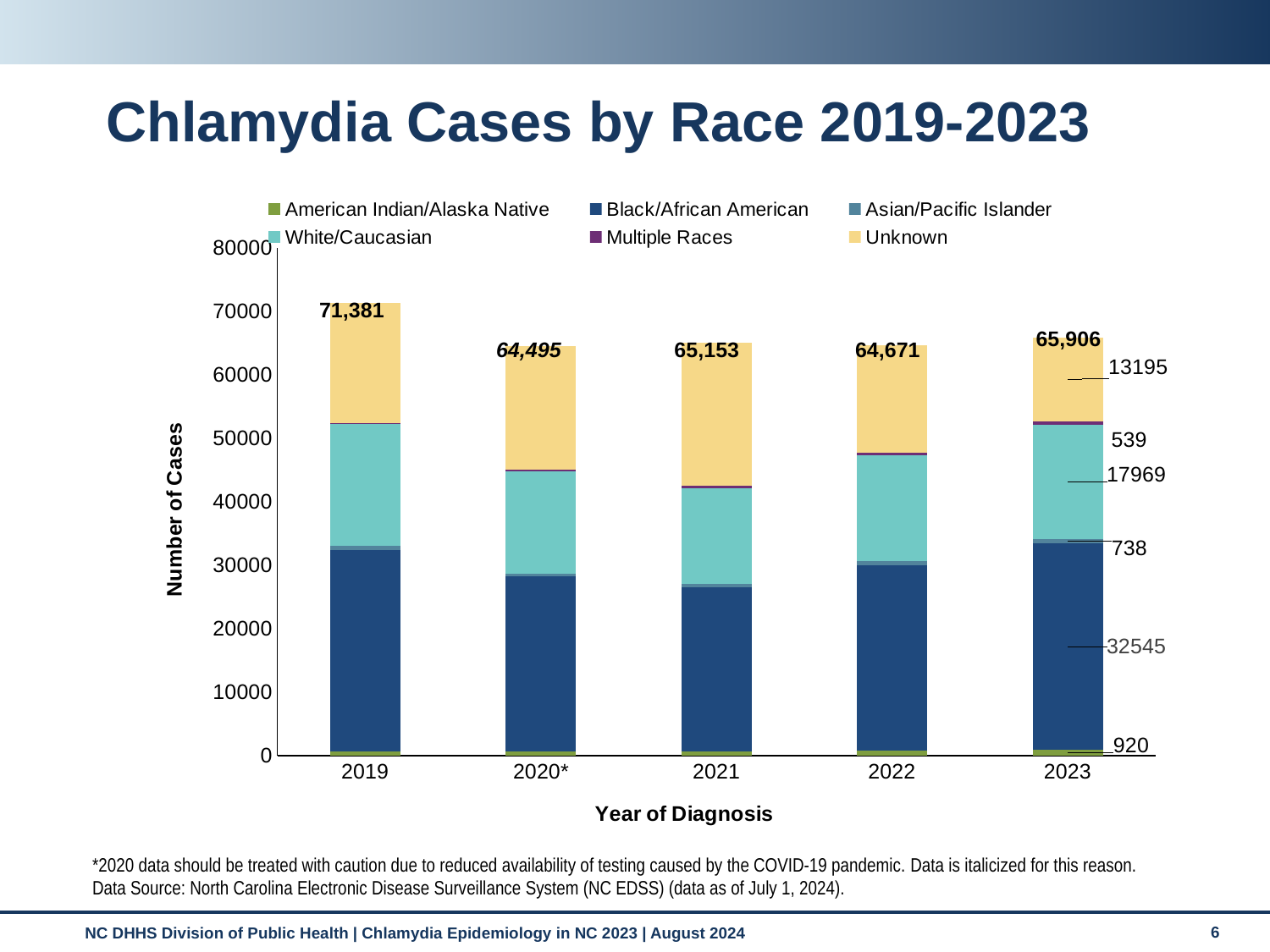
What is the total number of cases shown for 2023? 65,906 How many cases are labeled for Unknown race in 2023? 13195 Which year has the highest total number of cases? 2019 What is the difference between the total cases in 2019 and 2020*? 6,886 Which year has the lowest total number of cases? 2020* Which is larger in 2023: the Asian/Pacific Islander segment or the American Indian/Alaska Native segment? American Indian/Alaska Native How many cases are labeled for Black/African American in 2023? 32545 How many series does the legend list? 6 What is the total number of chlamydia cases shown for 2019? 71,381 What kind of chart is shown on the slide? Stacked bar chart Is the Black/African American segment for 2021 greater or less than 30000? less How many cases are labeled for White/Caucasian in 2023? 17969